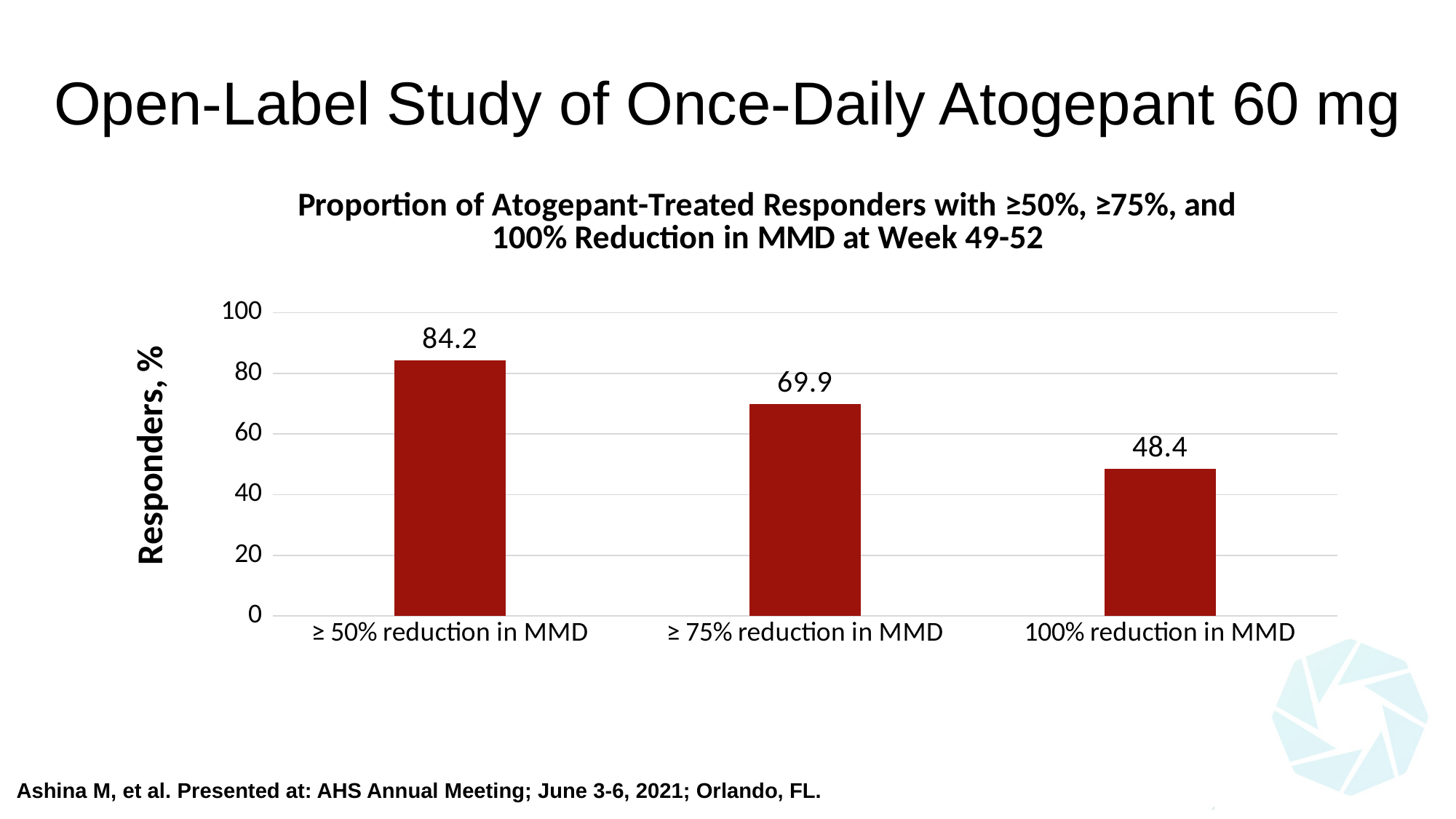
What is the difference between the values for ≥ 75% reduction in MMD and 100% reduction in MMD? 21.5 Which category has the highest value? ≥ 50% reduction in MMD Which is larger, the value for ≥ 75% reduction in MMD or the value for 100% reduction in MMD? ≥ 75% reduction in MMD Which category has the lowest value? 100% reduction in MMD Do the values rise or fall from left to right along the x axis? fall What is the value for ≥ 75% reduction in MMD? 69.9 What kind of chart is shown on the slide? bar chart How many categories are shown on the x axis? 3 Is the value for ≥ 75% reduction in MMD greater or less than 60? greater What is the difference between the values for ≥ 50% reduction in MMD and 100% reduction in MMD? 35.8 What is the value for 100% reduction in MMD? 48.4 What is the value for ≥ 50% reduction in MMD? 84.2